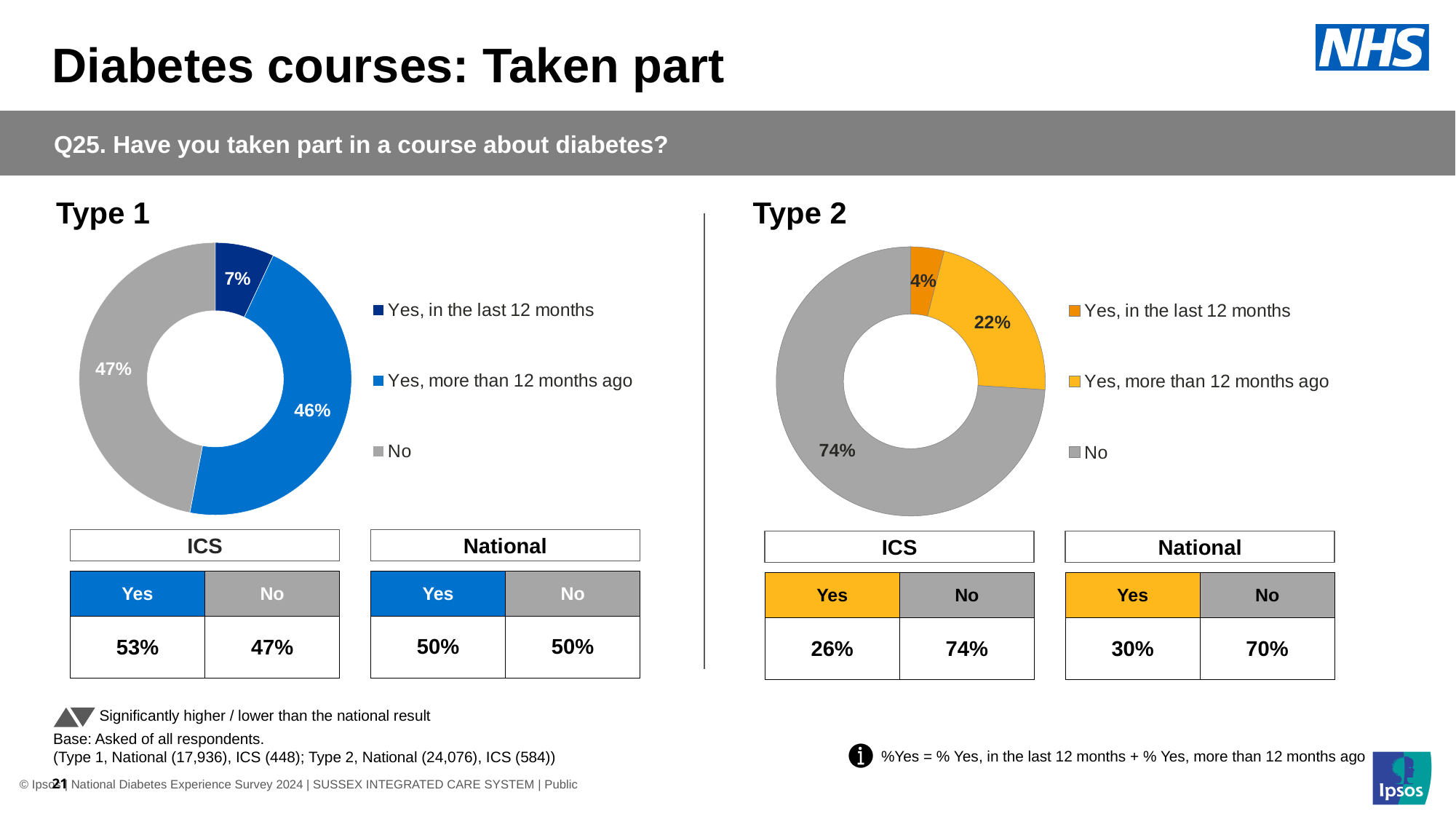
In the Type 1 chart, what percentage of respondents said 'Yes, more than 12 months ago'? 46% In the Type 1 chart, which category has the largest share? No What kind of chart is used to show the Type 1 results? Doughnut chart In the Type 1 chart, which is larger: 'Yes, more than 12 months ago' or 'Yes, in the last 12 months'? Yes, more than 12 months ago In the Type 2 chart, which category has the smallest share? Yes, in the last 12 months In the Type 1 chart, what percentage of respondents said 'Yes, in the last 12 months'? 7% In the Type 2 chart, what colour is the 'No' segment? Grey In the Type 2 chart, what percentage of respondents said 'No'? 74% How many categories does the legend of the Type 2 chart list? 3 In the Type 2 chart, what is the difference between the 'No' share and the 'Yes, more than 12 months ago' share? 52 percentage points In the Type 2 chart, what percentage of respondents said 'Yes, more than 12 months ago'? 22% In the Type 1 chart, what is the combined share of the two 'Yes' categories? 53%